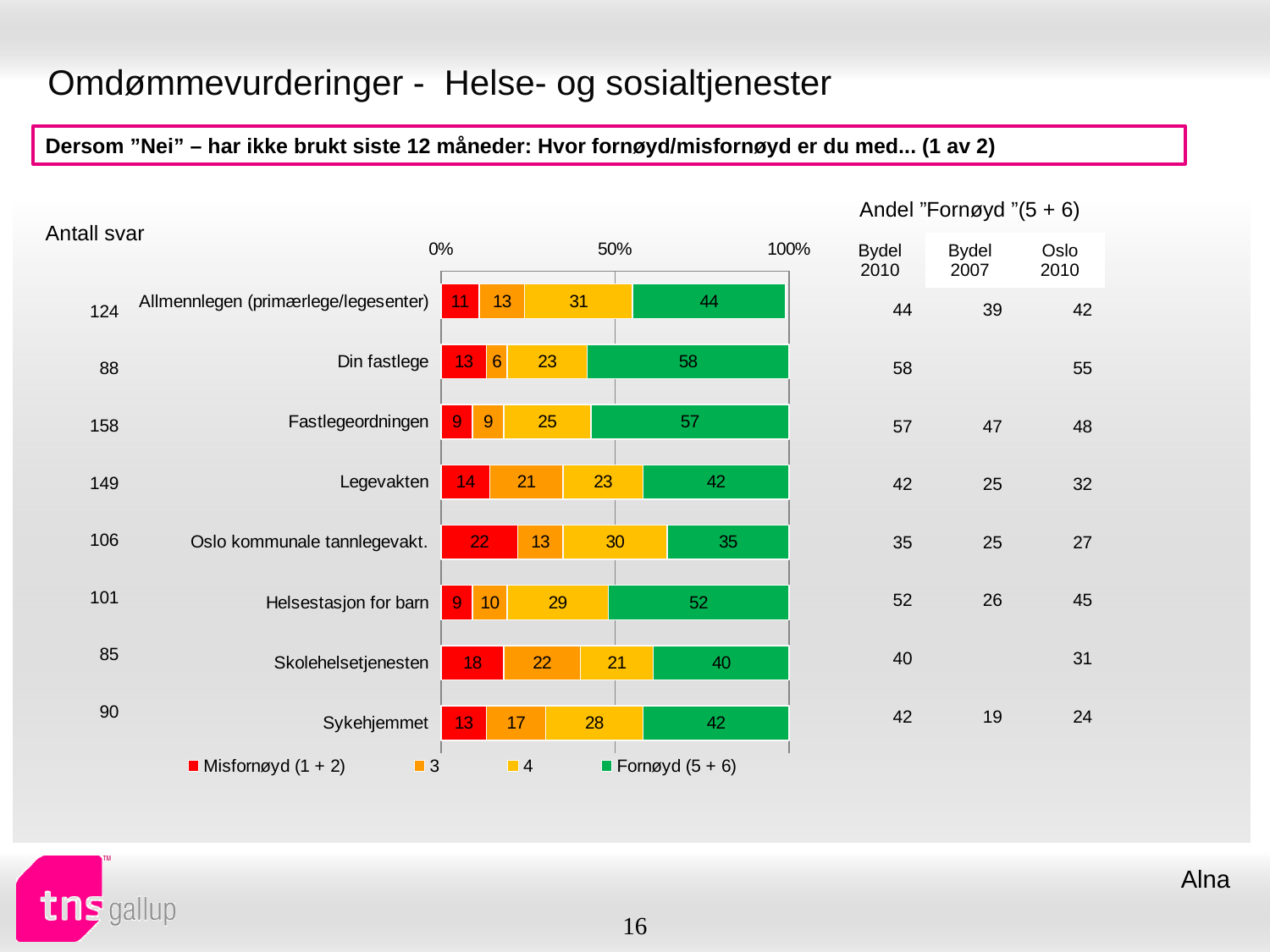
Is the Fornøyd (5 + 6) value larger for Fastlegeordningen or for Sykehjemmet? Fastlegeordningen Which category has the lowest Fornøyd (5 + 6) value? Oslo kommunale tannlegevakt. What type of chart is shown on the slide? stacked bar chart What is the difference between the Fornøyd (5 + 6) values for Din fastlege and Legevakten? 16 How many series does the chart legend list? 4 What is the Fornøyd (5 + 6) value for Din fastlege? 58 What is the value of series 3 for Legevakten? 21 How many categories are plotted in the chart? 8 Which category has the highest Fornøyd (5 + 6) value? Din fastlege What is the Misfornøyd (1 + 2) value for Oslo kommunale tannlegevakt.? 22 What is the value of series 4 for Helsestasjon for barn? 29 Which category has the highest Misfornøyd (1 + 2) value? Oslo kommunale tannlegevakt.